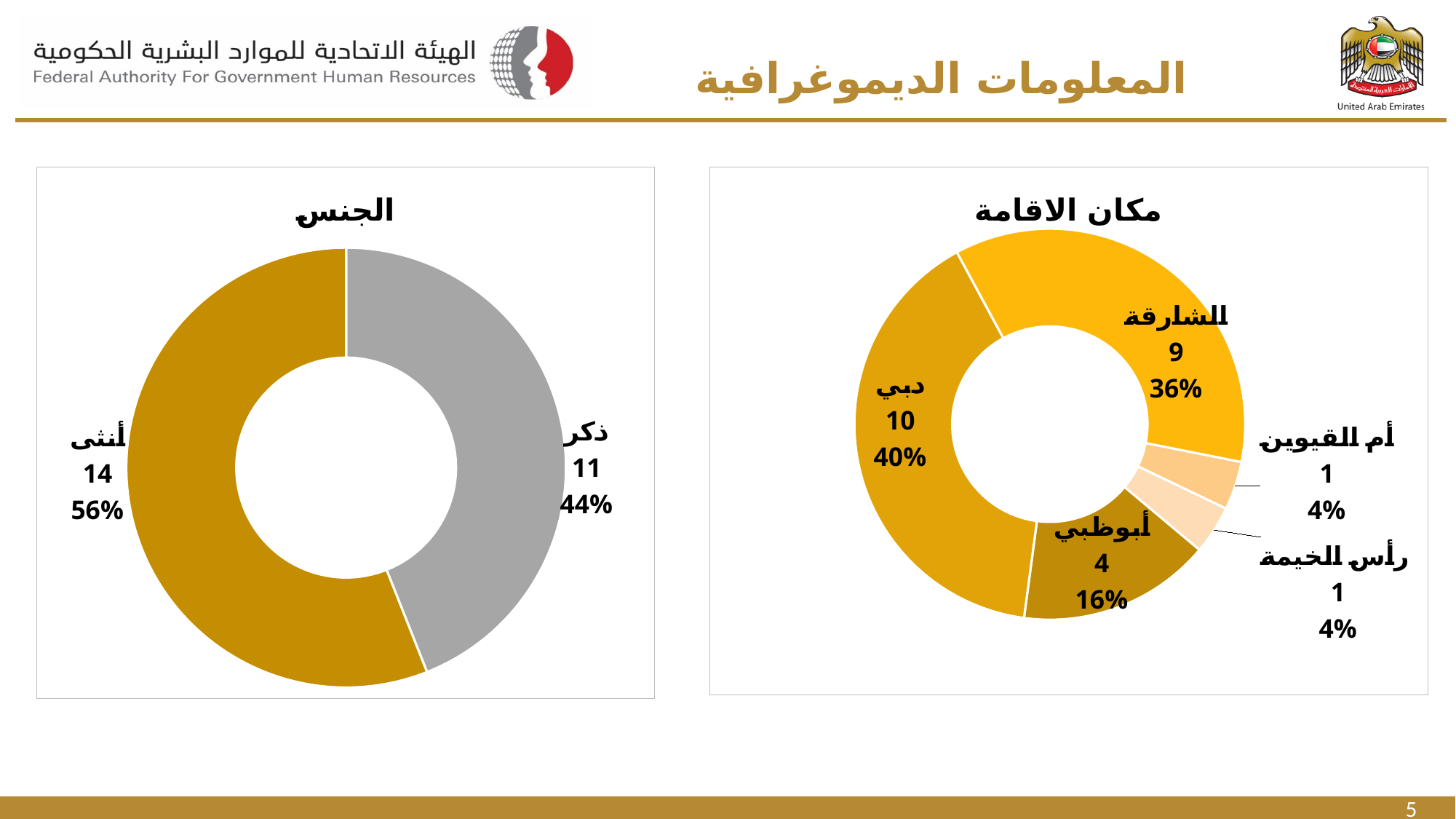
In the chart titled "الجنس", what percentage share does "ذكر" have? 44% In the chart titled "الجنس", which category has the larger value, "أنثى" or "ذكر"? أنثى In the chart titled "مكان الاقامة", what percentage share does "الشارقة" have? 36% In the chart titled "الجنس", what is the difference between the counts for "أنثى" and "ذكر"? 3 In the chart titled "مكان الاقامة", what is the total count across all categories? 25 In the chart titled "مكان الاقامة", what is the difference between the counts for "دبي" and "أبوظبي"? 6 In the chart titled "مكان الاقامة", how many categories are shown? 5 In the chart titled "الجنس", what is the count for "أنثى"? 14 In the chart titled "مكان الاقامة", what is the count for "دبي"? 10 In the chart titled "مكان الاقامة", which category has the highest value? دبي How many charts are shown on the slide? 2 What kind of chart is the chart titled "الجنس"? Doughnut chart